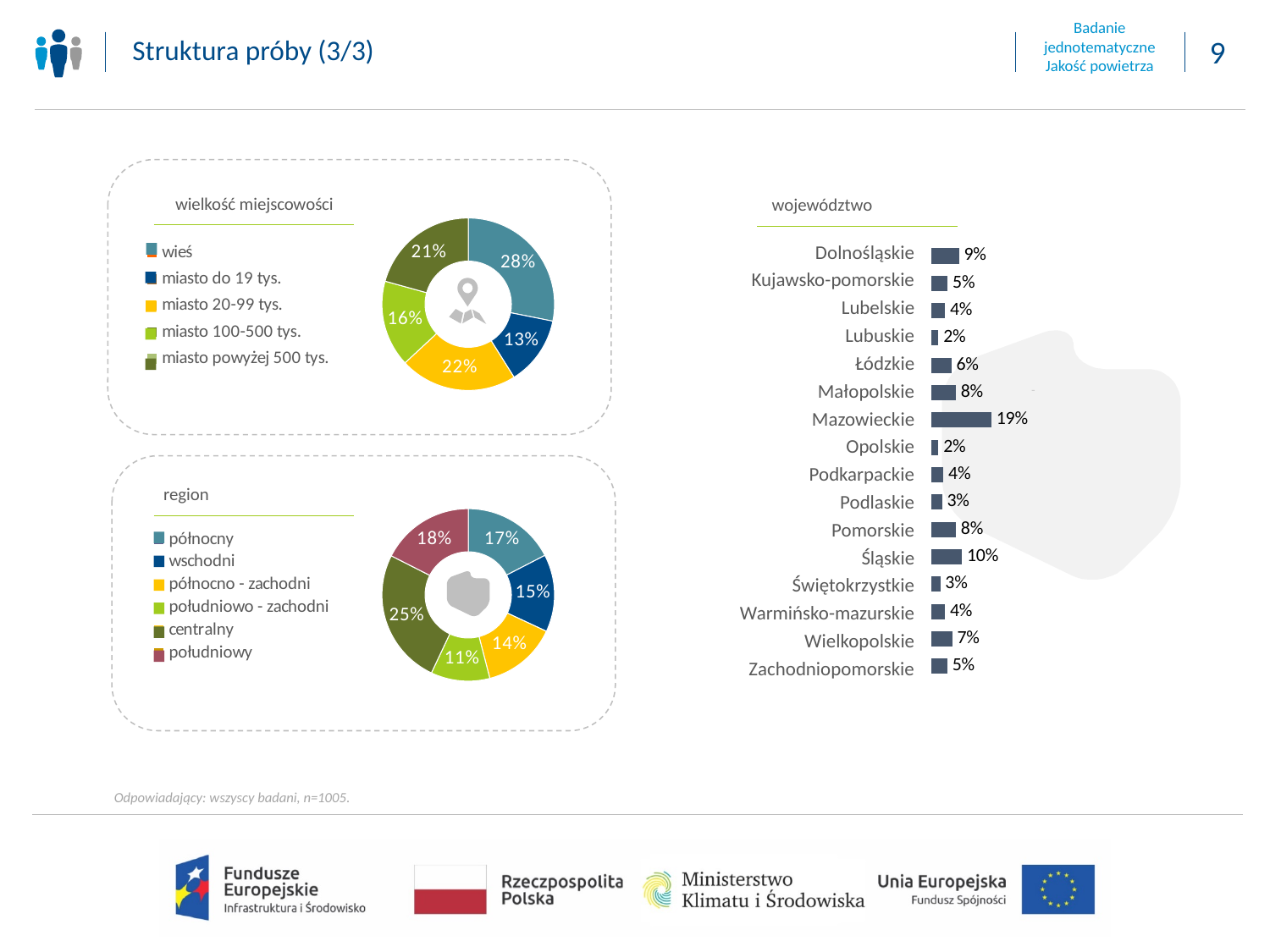
In the 'województwo' chart, what is the difference between Śląskie and Dolnośląskie? 1 percentage point In the 'region' chart, which is larger: 'północny' or 'wschodni'? północny In the 'województwo' chart, what is the value for Mazowieckie? 19% In the 'region' chart, which region has the smallest share? południowo - zachodni In the 'wielkość miejscowości' chart, how many categories does the legend list? 5 In the 'województwo' chart, which voivodeship has the highest value? Mazowieckie In the 'wielkość miejscowości' chart, what is the difference between 'miasto 20-99 tys.' and 'miasto 100-500 tys.'? 6 percentage points What kind of chart is the 'region' chart? Donut (pie) chart In the 'region' chart, what share is 'centralny'? 25% In the 'wielkość miejscowości' chart, which category has the smallest share? miasto do 19 tys. In the 'wielkość miejscowości' chart, what share is 'wieś'? 28% How many voivodeships are shown in the 'województwo' chart? 16